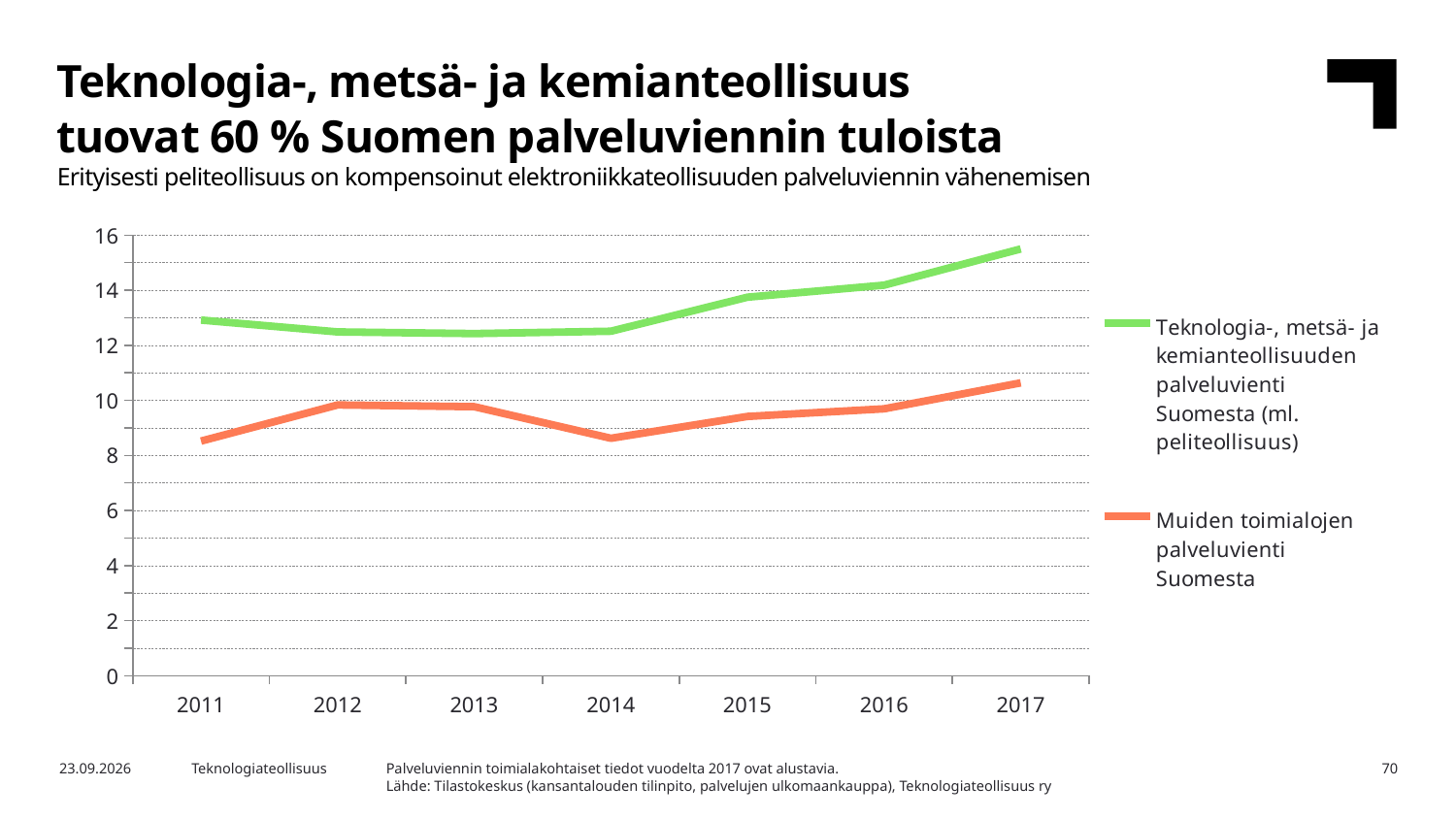
Is the value for Muiden toimialojen palveluvienti Suomesta in 2017 greater or less than 10? greater What kind of chart is shown on the slide? line chart How many series does the legend list? 2 Does the Teknologia-, metsä- ja kemianteollisuuden palveluvienti Suomesta series rise or fall from 2014 to 2017? rise Is the value for Muiden toimialojen palveluvienti Suomesta in 2011 greater or less than 10? less Which series has the higher value in 2015, Teknologia-, metsä- ja kemianteollisuuden palveluvienti Suomesta or Muiden toimialojen palveluvienti Suomesta? Teknologia-, metsä- ja kemianteollisuuden palveluvienti Suomesta In which year is the Teknologia-, metsä- ja kemianteollisuuden palveluvienti Suomesta series at its highest? 2017 What colour is the line for Muiden toimialojen palveluvienti Suomesta? orange Is the value for Teknologia-, metsä- ja kemianteollisuuden palveluvienti Suomesta in 2017 greater or less than 14? greater In which year is the Muiden toimialojen palveluvienti Suomesta series at its highest? 2017 How many years are plotted along the x axis? 7